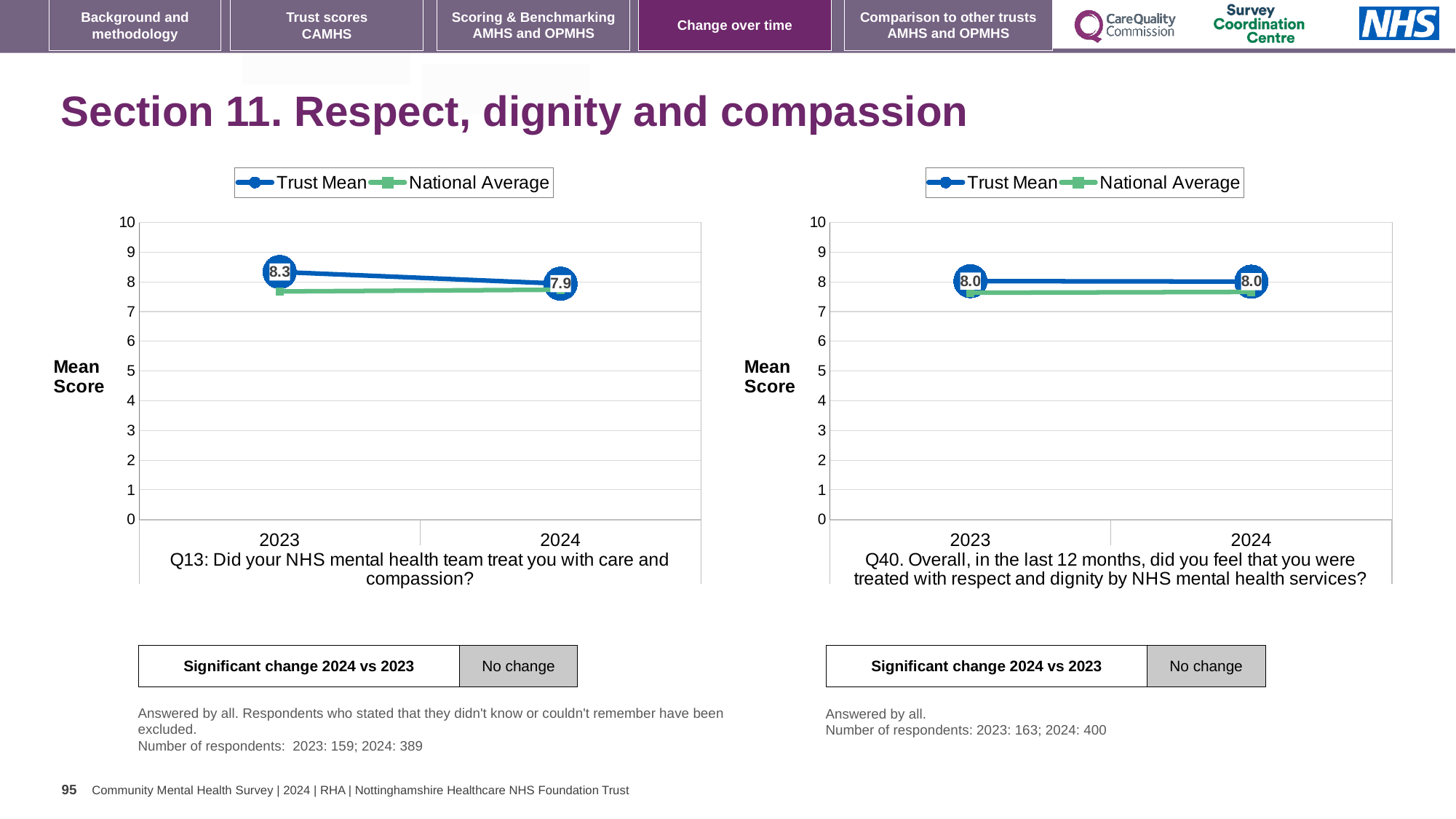
How many years are plotted on the x axis of the Q13 chart on the left? 2 In the Q13 chart on the left, does the Trust Mean rise or fall from 2023 to 2024? fall In the Q13 chart on the left, by how much did the Trust Mean change from 2023 to 2024? 0.4 How many series does the legend of the Q40 chart on the right list? 2 In the Q13 chart on the left, is the National Average for 2023 greater or less than 7? greater In the Q13 chart on the left, what is the Trust Mean for 2023? 8.3 What kind of chart is the Q13 chart on the left? line chart What is the label on the y axis of the Q40 chart on the right? Mean Score In the Q40 chart on the right, what is the Trust Mean for 2024? 8.0 In the Q13 chart on the left, what is the Trust Mean for 2024? 7.9 In the Q13 chart on the left, which is larger in 2023, the Trust Mean or the National Average? Trust Mean In the Q40 chart on the right, does the Trust Mean rise, fall or stay the same from 2023 to 2024? stays the same